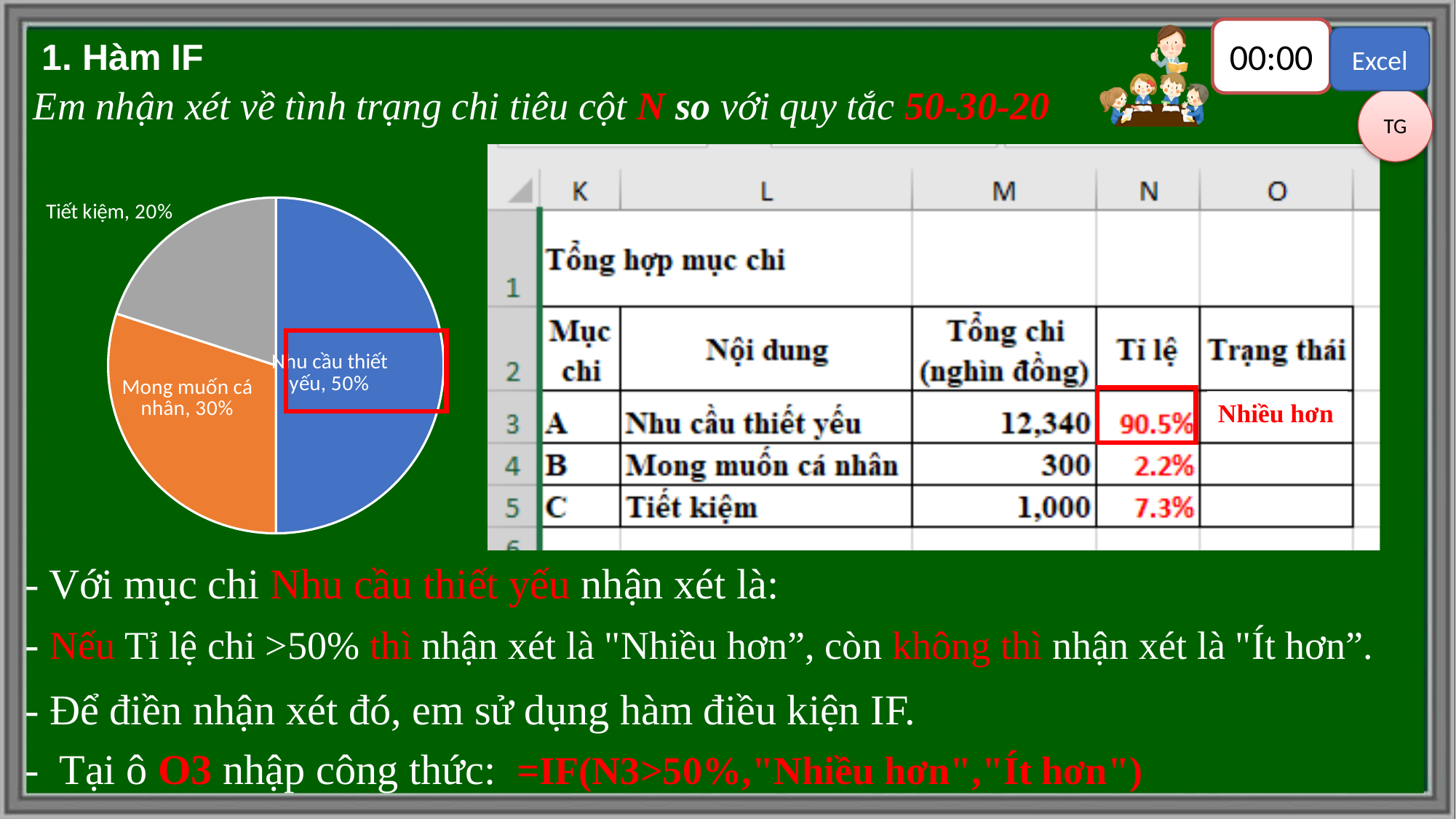
Which slice of the pie chart is the smallest? Tiết kiệm How many slices does the pie chart have? 3 What share of the pie does the Tiết kiệm slice represent? 20% What is the value shown for Tiết kiệm in the pie chart? 20% What colour is the Nhu cầu thiết yếu slice in the pie chart? blue What kind of chart is shown on the left of the slide? pie chart What is the value shown for Nhu cầu thiết yếu in the pie chart? 50% Which slice of the pie chart is the largest? Nhu cầu thiết yếu In the pie chart, which is larger: Nhu cầu thiết yếu or Mong muốn cá nhân? Nhu cầu thiết yếu What is the value shown for Mong muốn cá nhân in the pie chart? 30% What is the difference between the Mong muốn cá nhân and Tiết kiệm slices in the pie chart? 10% What colour is the Mong muốn cá nhân slice in the pie chart? orange